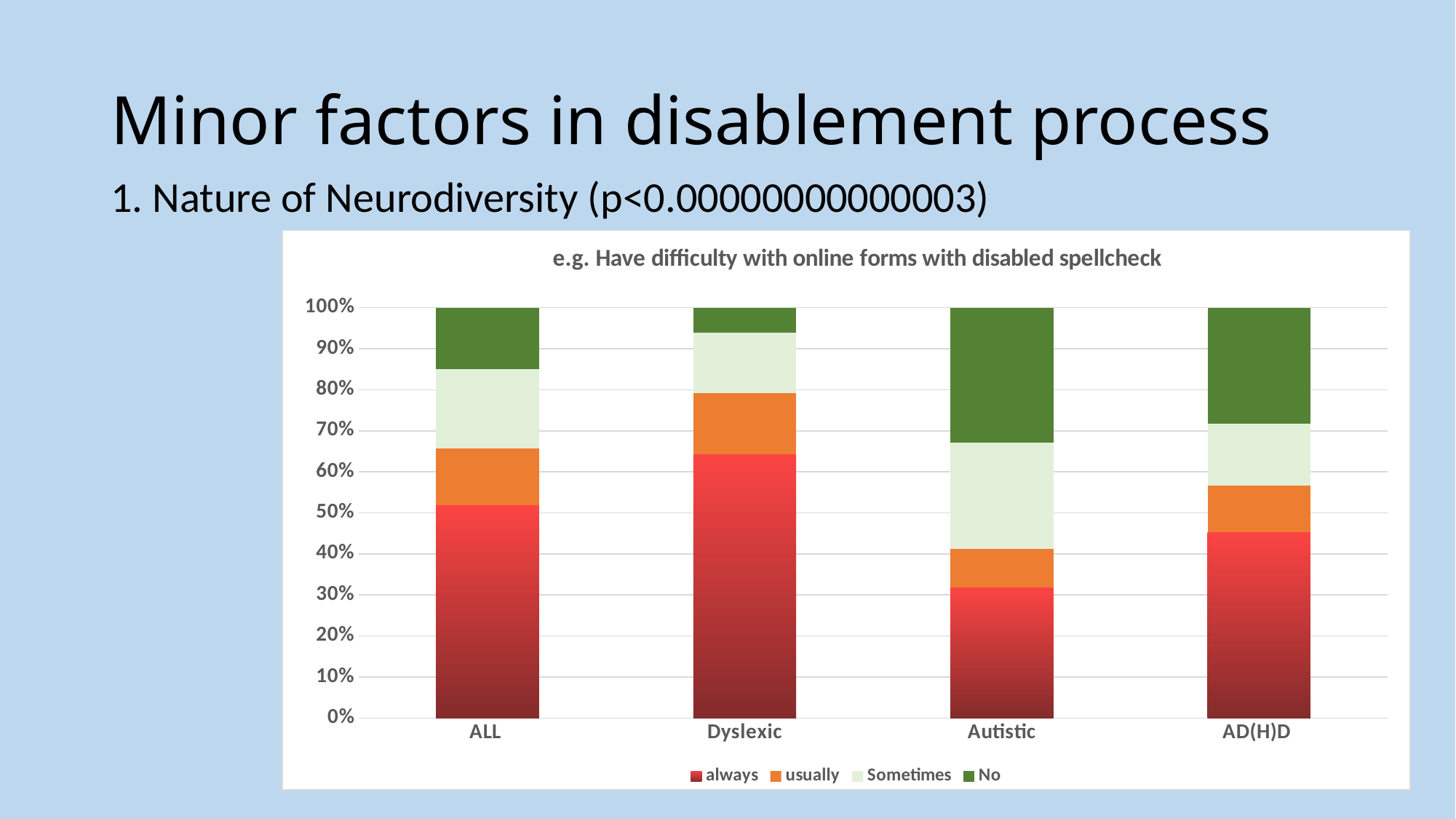
How many categories are shown along the x axis of the chart? 4 Is the 'always' value for Dyslexic greater or less than 60%? greater Which category has the smallest 'always' segment? Autistic Which category has the largest 'No' segment? Autistic Which category has the largest 'always' segment? Dyslexic Is the 'always' value for Autistic greater or less than 40%? less How many series does the chart's legend list? 4 What is the title of the chart? e.g. Have difficulty with online forms with disabled spellcheck Which category has the smallest 'No' segment? Dyslexic What is the total height of each stacked bar in the chart? 100% What kind of chart is shown on the slide? stacked bar chart Which is larger, the 'always' segment for ALL or the 'always' segment for AD(H)D? ALL